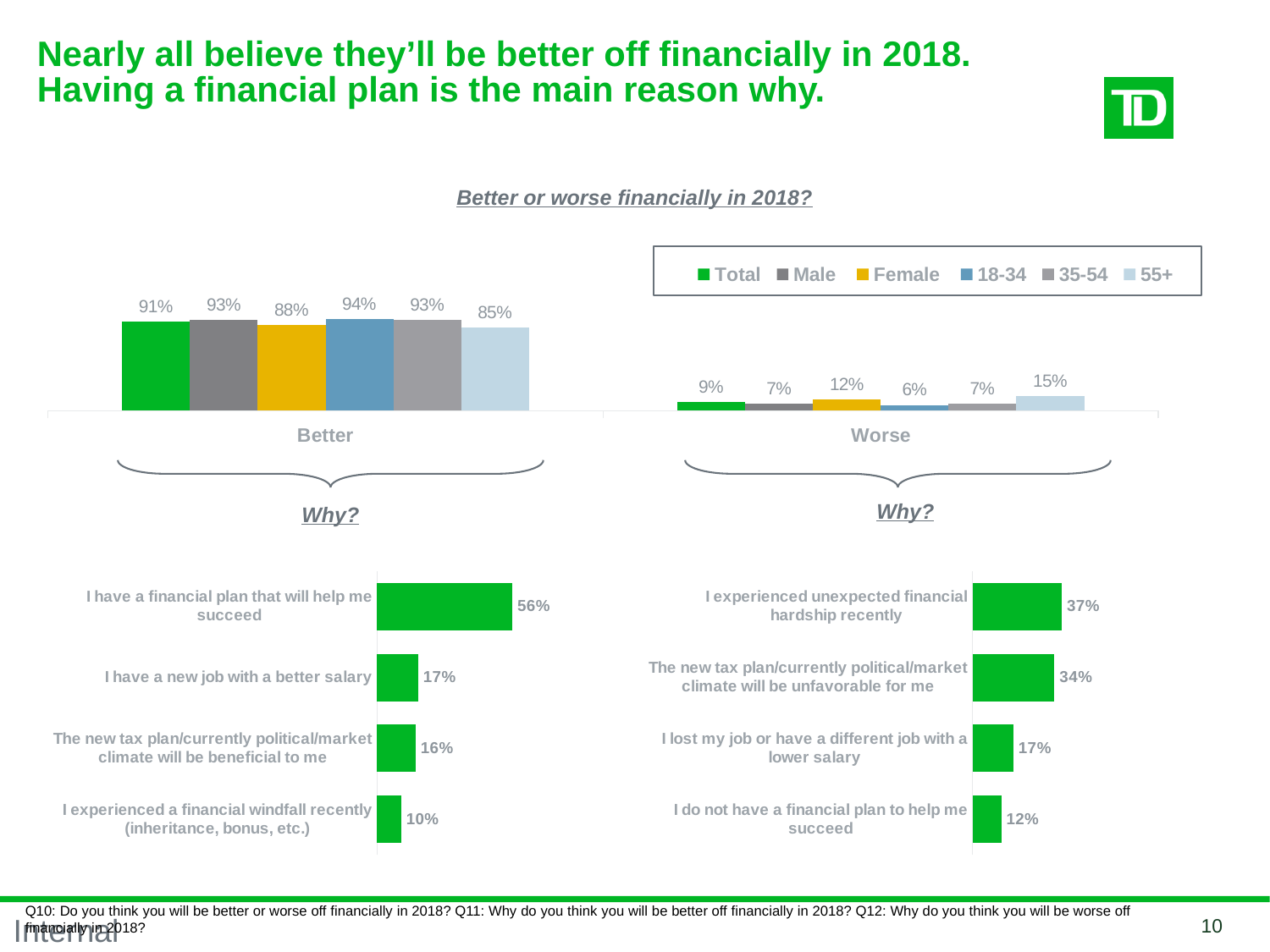
In the 'Better or worse financially in 2018?' chart, what is the Total value for Better? 91% In the 'Better or worse financially in 2018?' chart, what colour represents the Female series? Yellow In the bottom-right 'Why?' chart, what is the difference between 'I experienced unexpected financial hardship recently' and 'The new tax plan/currently political/market climate will be unfavorable for me'? 3% What kind of chart is the bottom-right 'Why?' chart? Bar chart In the 'Better or worse financially in 2018?' chart, what is the 55+ value for Worse? 15% In the bottom-left 'Why?' chart, what percentage said 'I have a financial plan that will help me succeed'? 56% In the 'Better or worse financially in 2018?' chart, is the Female value for Worse larger or smaller than the 18-34 value for Worse? larger How many series does the legend of the 'Better or worse financially in 2018?' chart list? 6 In the bottom-left 'Why?' chart, which reason has the lowest value? I experienced a financial windfall recently (inheritance, bonus, etc.) In the 'Better or worse financially in 2018?' chart, what is the difference between the Male and Female values for Better? 5% In the 'Better or worse financially in 2018?' chart, which series has the highest value for Worse? 55+ In the 'Better or worse financially in 2018?' chart, which series has the lowest value for Better? 55+